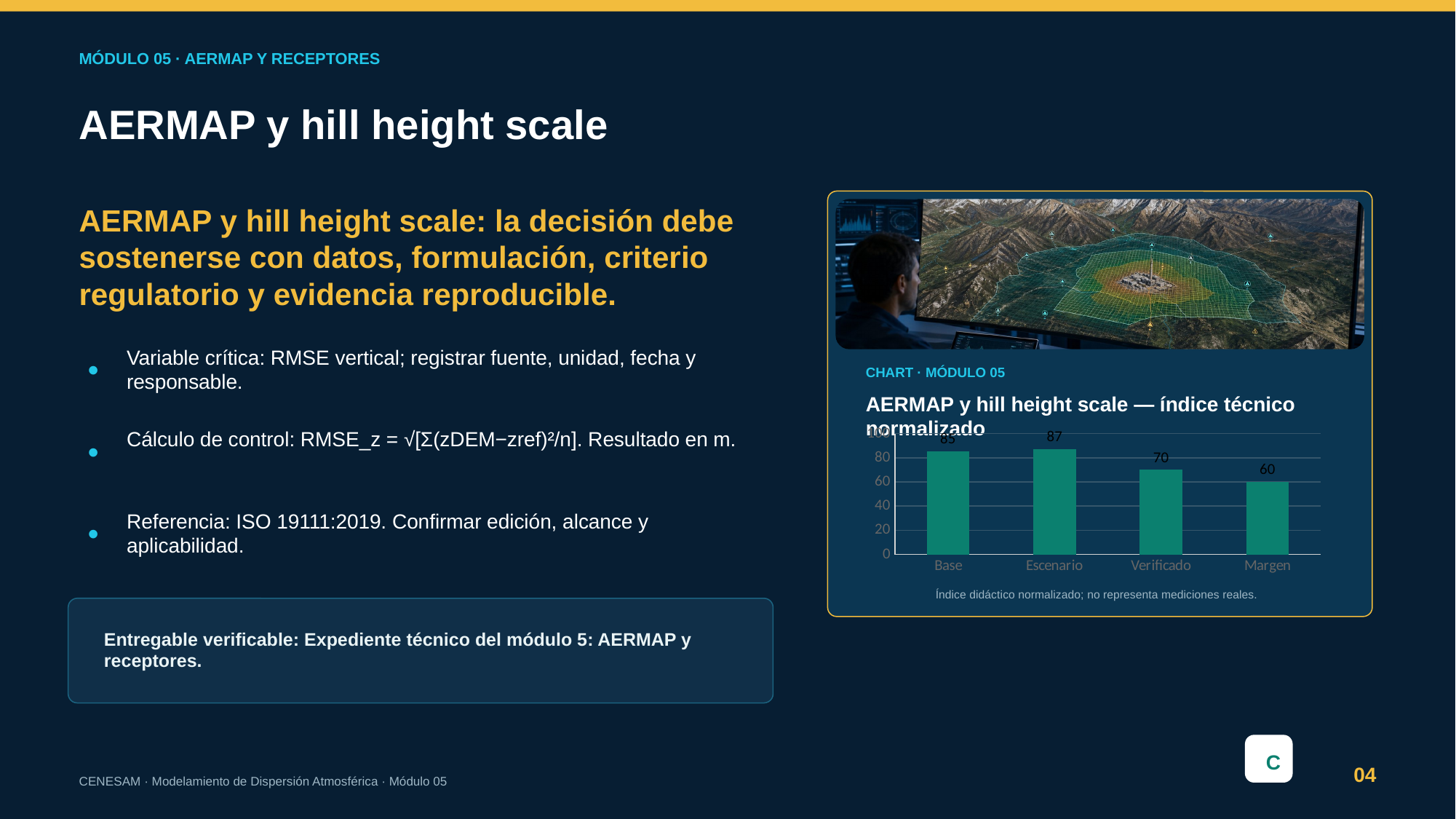
What is the value for Margen? 60 What kind of chart is shown on the slide? bar chart Is the value for Verificado greater or less than 80? less What is the value for Escenario? 87 How many categories are shown on the x axis? 4 Which category has the lowest value? Margen What is the title of the chart? AERMAP y hill height scale — índice técnico normalizado What is the difference between the values for Escenario and Margen? 27 Which category has the highest value? Escenario Which is larger, the value for Base or the value for Verificado? Base What is the difference between the values for Base and Verificado? 15 What is the value for Verificado? 70